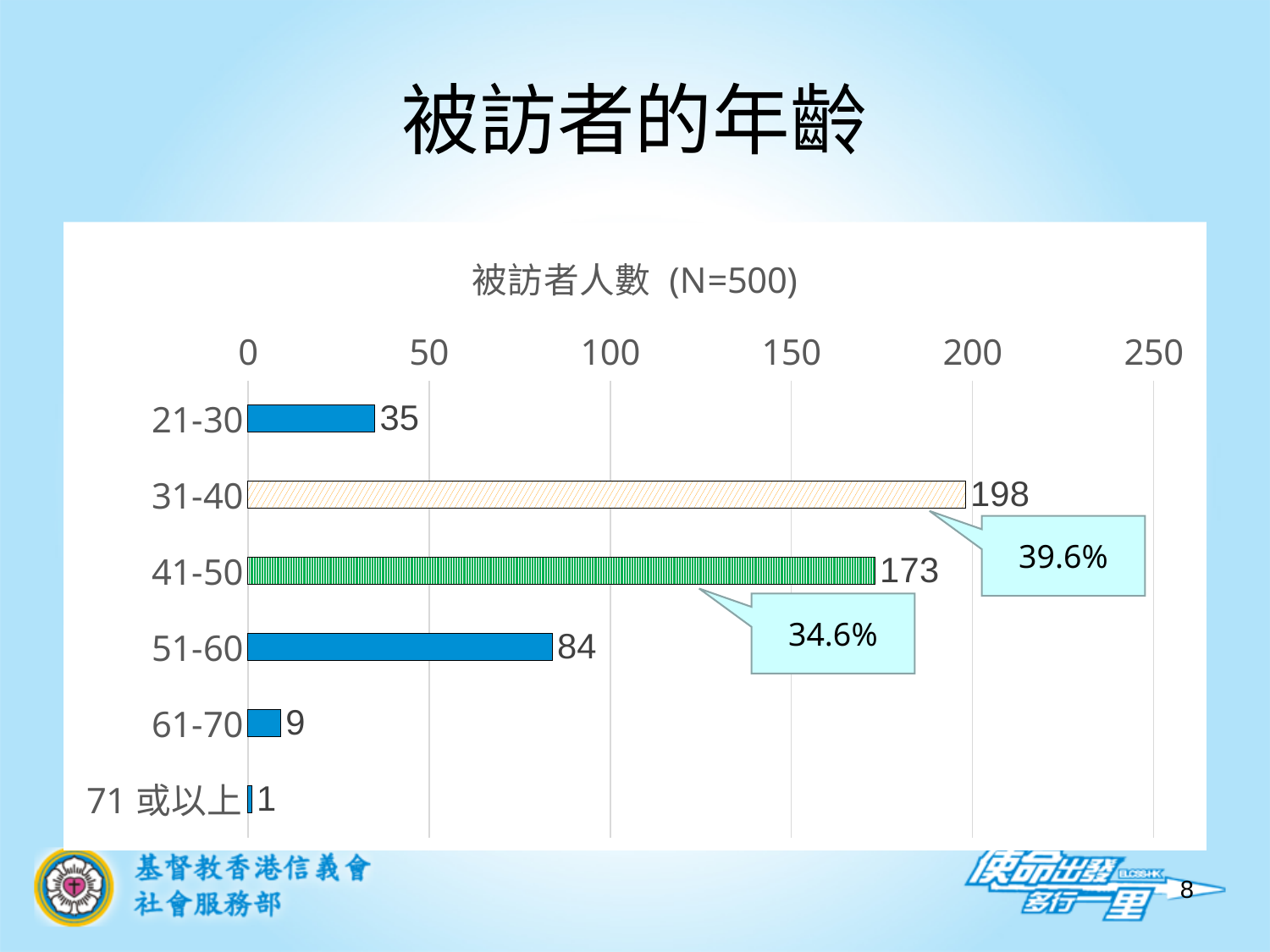
Which is larger, the value for 21-30 or the value for 51-60? 51-60 Is the value for 41-50 greater or less than 150? greater Which age group has the highest number of respondents? 31-40 What is the difference between the values for 51-60 and 21-30? 49 How many age groups are shown in the chart? 6 What is the value for the 31-40 age group? 198 What is the value for the 51-60 age group? 84 What is the value for the 61-70 age group? 9 What is the difference between the values for 31-40 and 41-50? 25 What kind of chart is shown on the slide? bar chart What percentage is shown in the callout attached to the 31-40 bar? 39.6% Which age group has the lowest number of respondents? 71 或以上